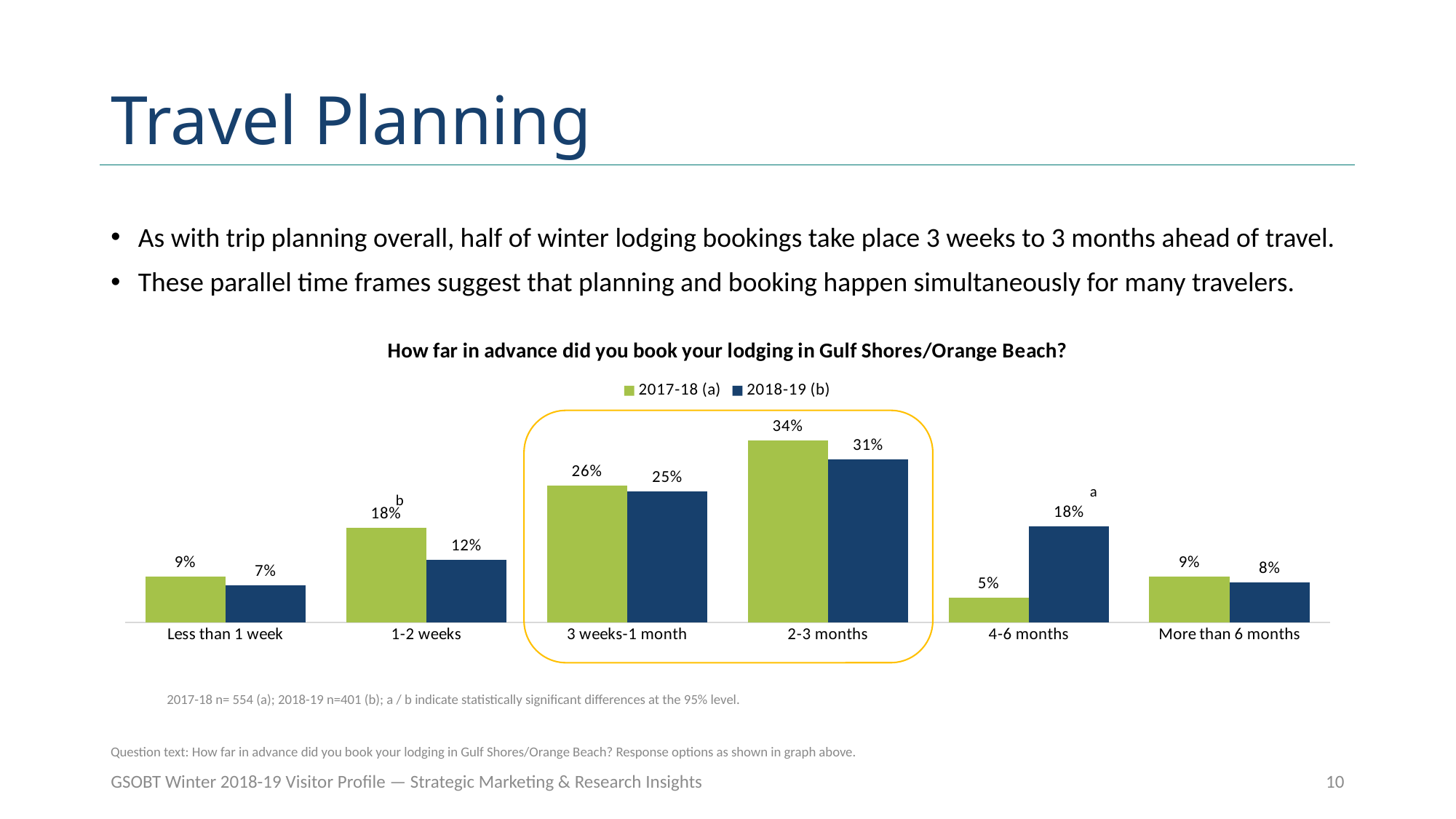
What is the 2017-18 (a) value for 2-3 months? 34% What is the 2018-19 (b) value for 4-6 months? 18% Which is larger for 1-2 weeks: the 2017-18 (a) value or the 2018-19 (b) value? 2017-18 (a) Which category has the highest 2018-19 (b) value? 2-3 months How many categories are shown on the x axis? 6 Which category has the lowest 2017-18 (a) value? 4-6 months What is the title of the chart? How far in advance did you book your lodging in Gulf Shores/Orange Beach? How many series does the legend list? 2 Which colour represents the 2018-19 (b) series? Dark blue What kind of chart is shown on the slide? Bar chart What is the 2018-19 (b) value for 1-2 weeks? 12% What is the difference between the 2017-18 (a) and 2018-19 (b) values for 4-6 months? 13%